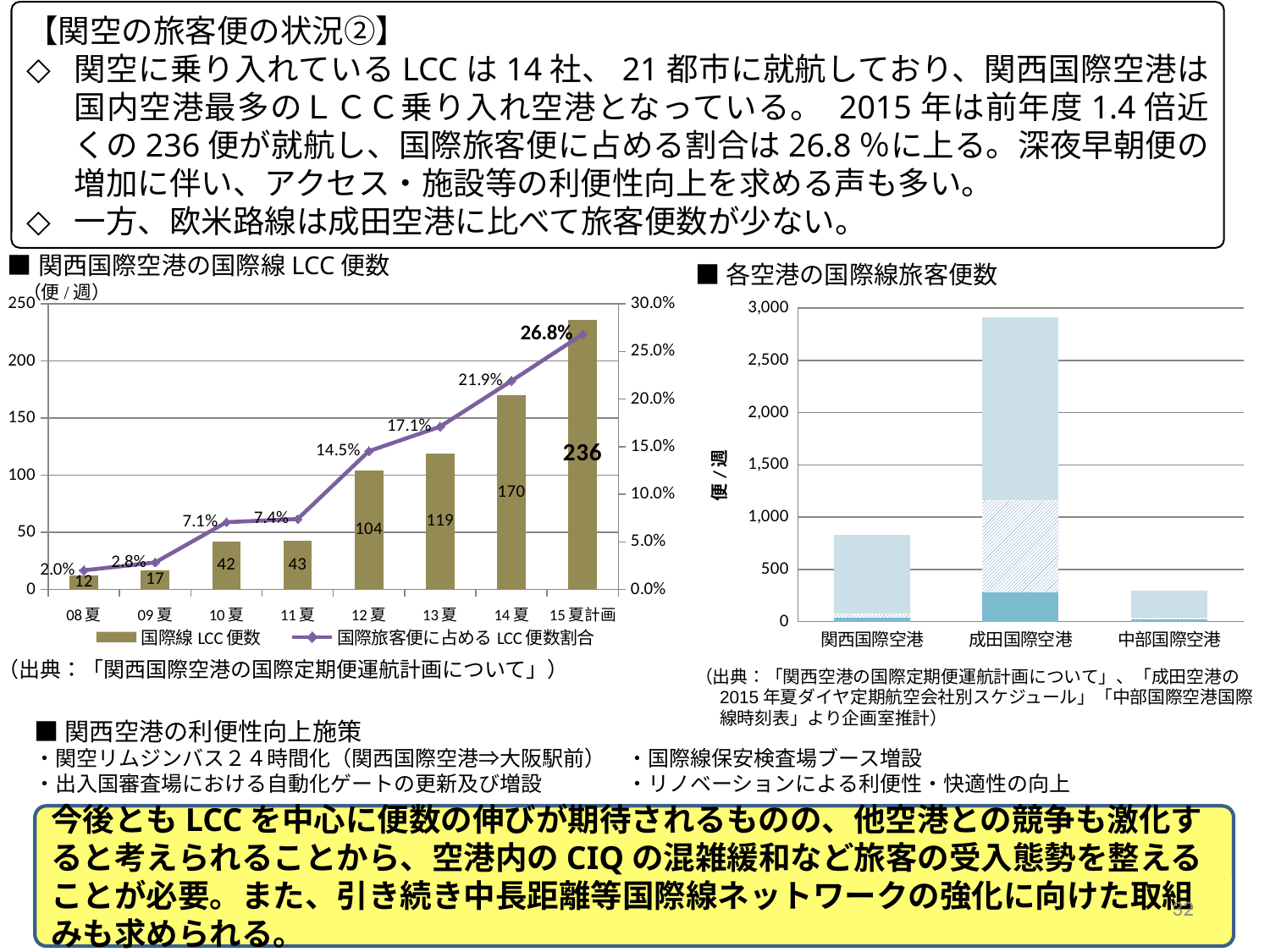
In the chart titled 関西国際空港の国際線LCC便数, what is the value of 国際線LCC便数 for 14夏? 170 What kind of chart is the chart titled 各空港の国際線旅客便数? stacked bar chart In the chart titled 関西国際空港の国際線LCC便数, which category has the lowest 国際線LCC便数? 08夏 In the chart titled 関西国際空港の国際線LCC便数, does the 国際旅客便に占めるLCC便数割合 rise or fall from 08夏 to 15夏計画? rise In the chart titled 各空港の国際線旅客便数, is the total value for 成田国際空港 greater or less than 2,500? greater In the chart titled 関西国際空港の国際線LCC便数, what is the difference in 国際線LCC便数 between 15夏計画 and 14夏? 66 In the chart titled 関西国際空港の国際線LCC便数, which category has the highest 国際線LCC便数? 15夏計画 In the chart titled 関西国際空港の国際線LCC便数, what is the 国際旅客便に占めるLCC便数割合 for 12夏? 14.5% In the chart titled 関西国際空港の国際線LCC便数, how many categories are shown on the x axis? 8 In the chart titled 関西国際空港の国際線LCC便数, which is larger, the 国際線LCC便数 for 12夏 or for 13夏? 13夏 In the chart titled 関西国際空港の国際線LCC便数, how many series does the legend list? 2 In the chart titled 各空港の国際線旅客便数, is the total value for 中部国際空港 greater or less than 500? less